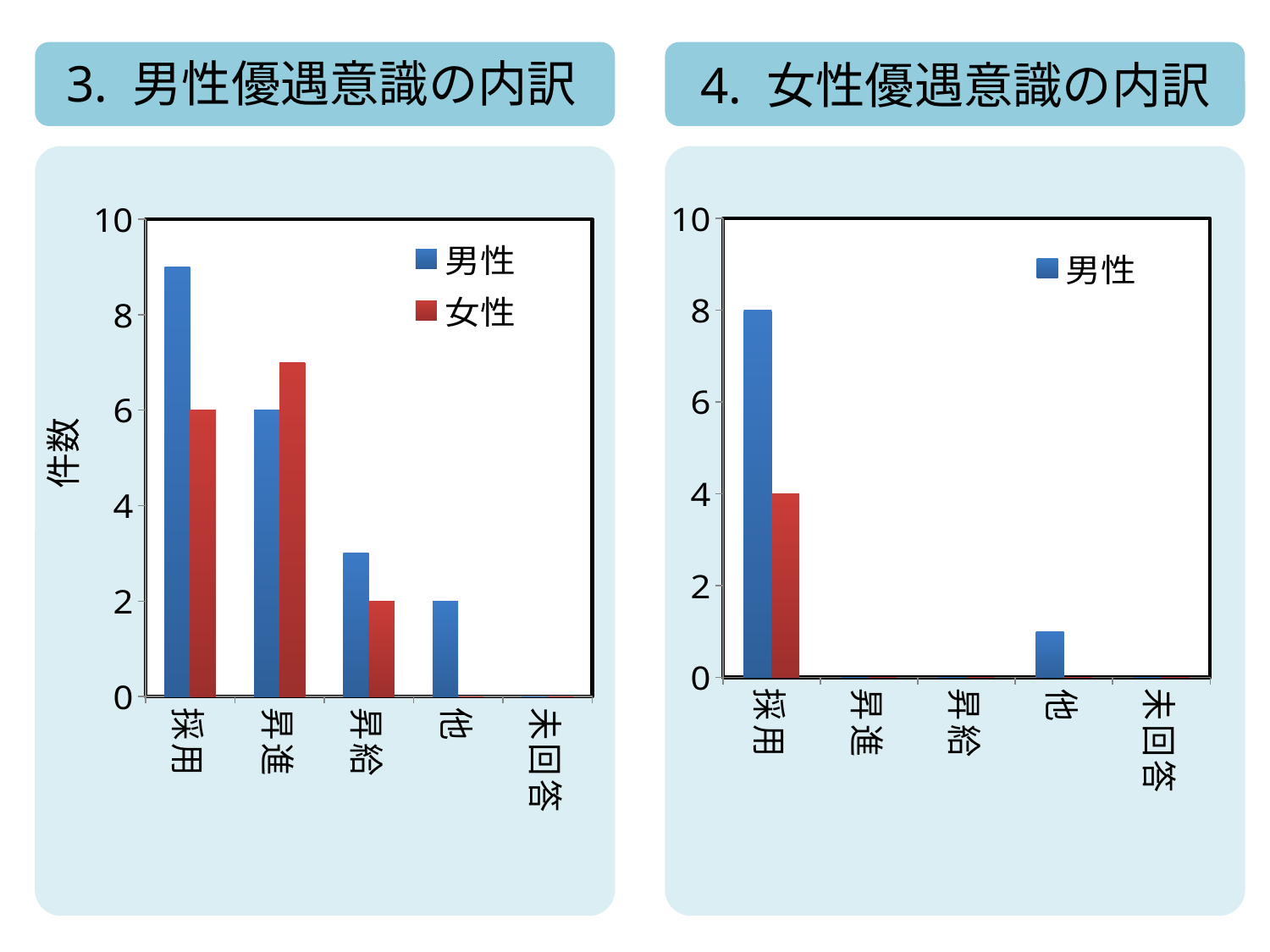
In the chart titled 4. 女性優遇意識の内訳, is the 男性 value for 他 greater or less than 2? less In the chart titled 3. 男性優遇意識の内訳, how many series does the legend list? 2 In the chart titled 3. 男性優遇意識の内訳, what is the 男性 value for 他? 2 In the chart titled 3. 男性優遇意識の内訳, is the 女性 value for 昇進 greater or less than 6? greater In the chart titled 3. 男性優遇意識の内訳, is the 男性 value for 採用 greater or less than 8? greater In the chart titled 3. 男性優遇意識の内訳, which category has the highest 男性 value? 採用 In the chart titled 3. 男性優遇意識の内訳, what is the 男性 value for 昇進? 6 In the chart titled 3. 男性優遇意識の内訳, what is the 女性 value for 採用? 6 In the chart titled 4. 女性優遇意識の内訳, how many categories are shown on the x axis? 5 In the chart titled 4. 女性優遇意識の内訳, what is the 男性 value for 採用? 8 In the chart titled 4. 女性優遇意識の内訳, what is the value of the red bar for 採用? 4 In the chart titled 3. 男性優遇意識の内訳, for 昇進, which series is larger, 男性 or 女性? 女性